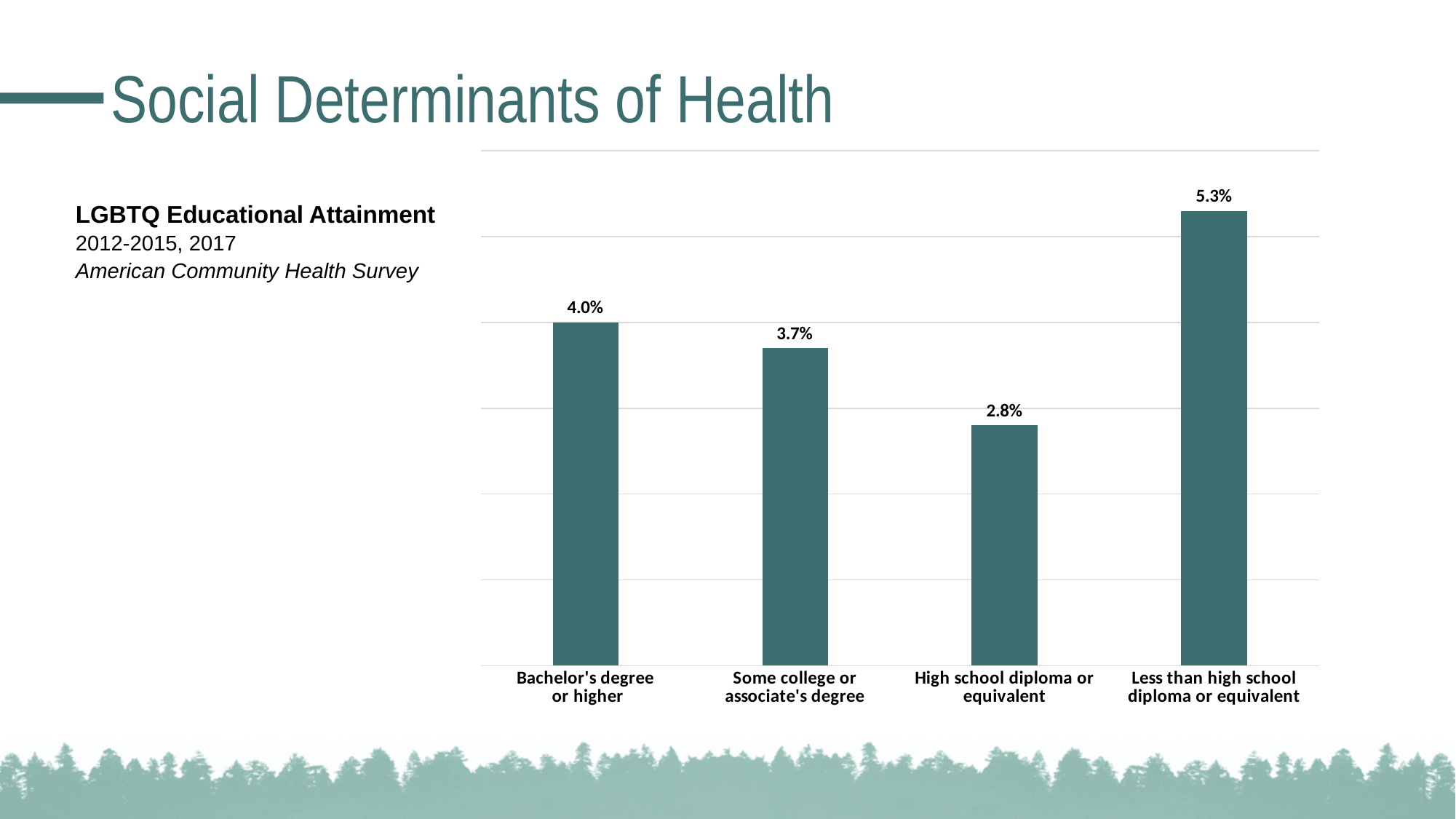
What is the value for Bachelor's degree or higher? 4.0% How many categories are shown in the chart? 4 What is the difference between the values for Bachelor's degree or higher and Some college or associate's degree? 0.3% What is the title of the chart described on the slide? LGBTQ Educational Attainment What is the value for Less than high school diploma or equivalent? 5.3% Which is larger, the value for Bachelor's degree or higher or the value for High school diploma or equivalent? Bachelor's degree or higher What is the value for Some college or associate's degree? 3.7% Which category has the highest value? Less than high school diploma or equivalent What kind of chart is shown on the slide? Bar chart What is the value for High school diploma or equivalent? 2.8% What is the difference between the values for Less than high school diploma or equivalent and High school diploma or equivalent? 2.5% Which category has the lowest value? High school diploma or equivalent